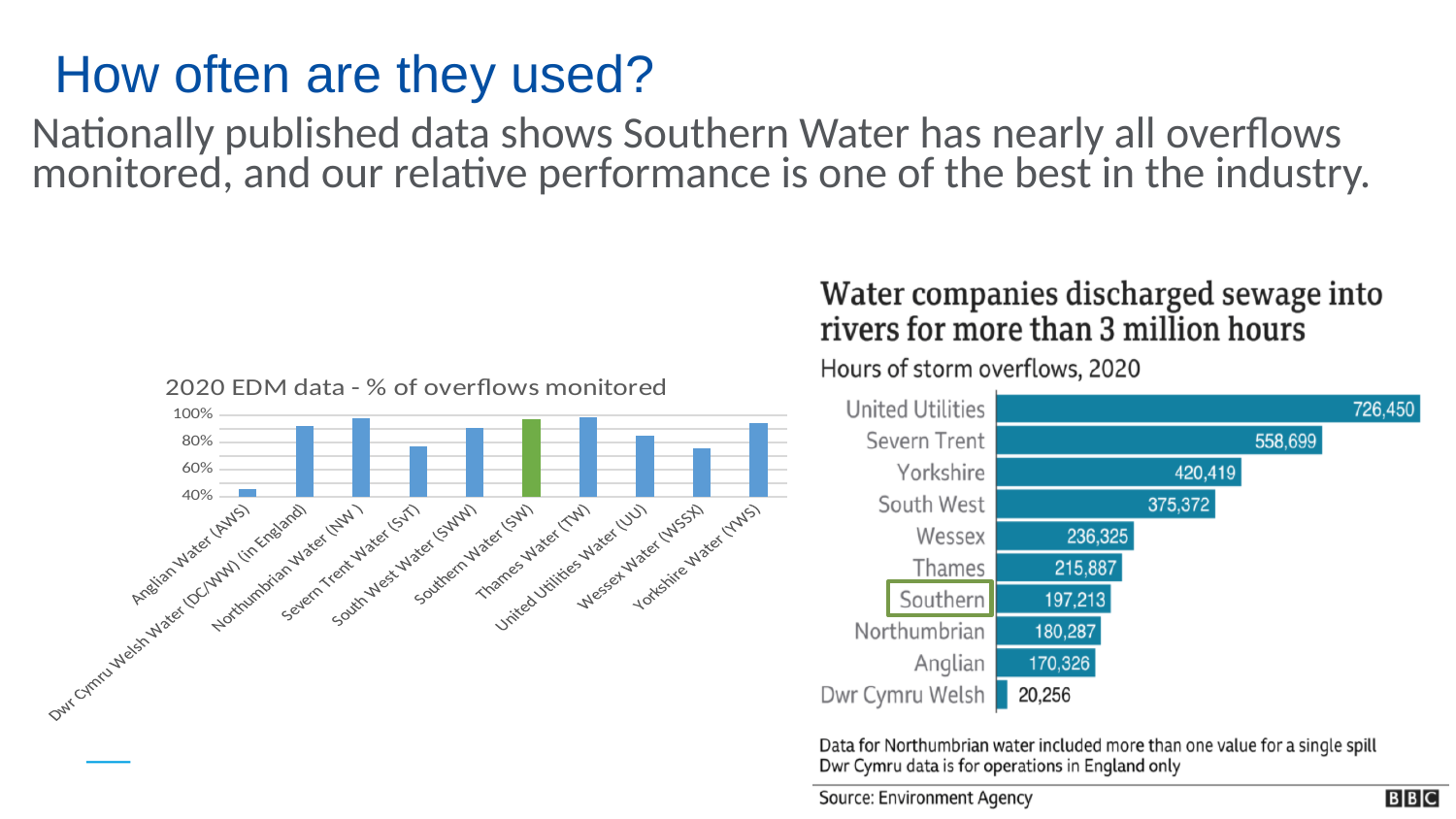
In the chart titled '2020 EDM data - % of overflows monitored', is the value for Severn Trent Water (SvT) greater or less than 80%? less In the chart titled '2020 EDM data - % of overflows monitored', which bar is coloured green rather than blue? Southern Water (SW) In the chart titled 'Water companies discharged sewage into rivers for more than 3 million hours', what is the difference between United Utilities and Severn Trent? 167,751 In the chart titled 'Water companies discharged sewage into rivers for more than 3 million hours', what is the difference between Southern and Northumbrian? 16,926 In the chart titled 'Water companies discharged sewage into rivers for more than 3 million hours', what is the value for United Utilities? 726,450 In the chart titled '2020 EDM data - % of overflows monitored', which company has the lowest percentage of overflows monitored? Anglian Water (AWS) In the chart titled 'Water companies discharged sewage into rivers for more than 3 million hours', which company has the lowest hours of storm overflows? Dwr Cymru Welsh In the chart titled 'Water companies discharged sewage into rivers for more than 3 million hours', what is the value for Southern? 197,213 In the chart titled 'Water companies discharged sewage into rivers for more than 3 million hours', which company has the highest hours of storm overflows? United Utilities In the chart titled '2020 EDM data - % of overflows monitored', is the value for Anglian Water (AWS) greater or less than 60%? less In the chart titled 'Water companies discharged sewage into rivers for more than 3 million hours', how many companies are shown? 10 In the chart titled 'Water companies discharged sewage into rivers for more than 3 million hours', which is larger, Wessex or Thames? Wessex